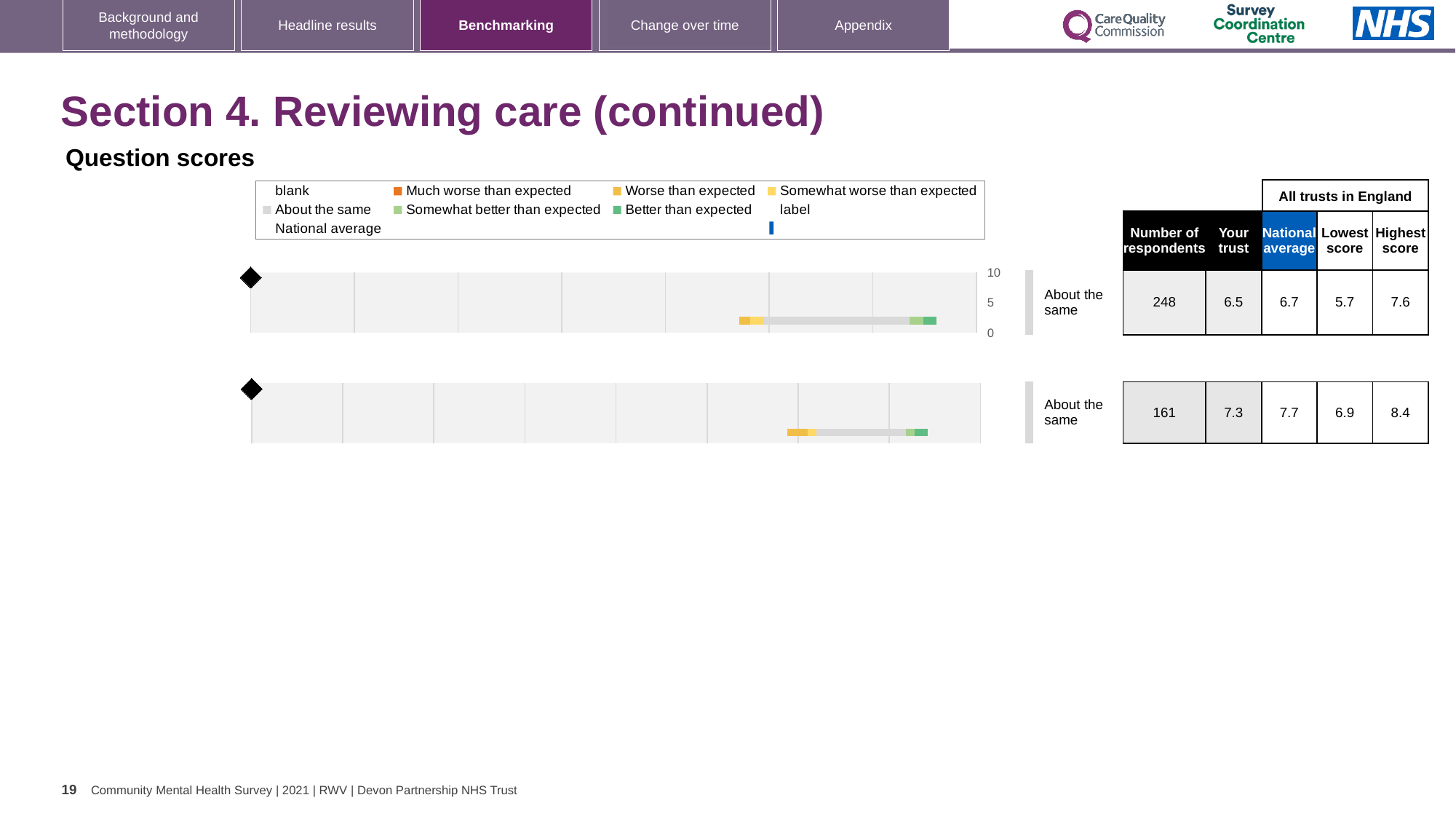
For the top chart, what is the score for your trust? 6.5 For the top chart, what is the number of respondents? 248 What kind of chart is used on this slide to show the question scores? bar chart For the bottom chart, what is the difference between the national average and your trust's score? 0.4 What benchmark category is shown next to both charts? About the same For the bottom chart, which is larger: your trust's score or the national average? National average For the bottom chart, what is the lowest score among all trusts in England? 6.9 How many benchmarking charts are shown on the slide? 2 What is the maximum value shown on the chart axis? 10 For the top chart, what is the national average score? 6.7 For the top chart, what is the difference between the highest score and the lowest score? 1.9 For the bottom chart, what is the highest score among all trusts in England? 8.4